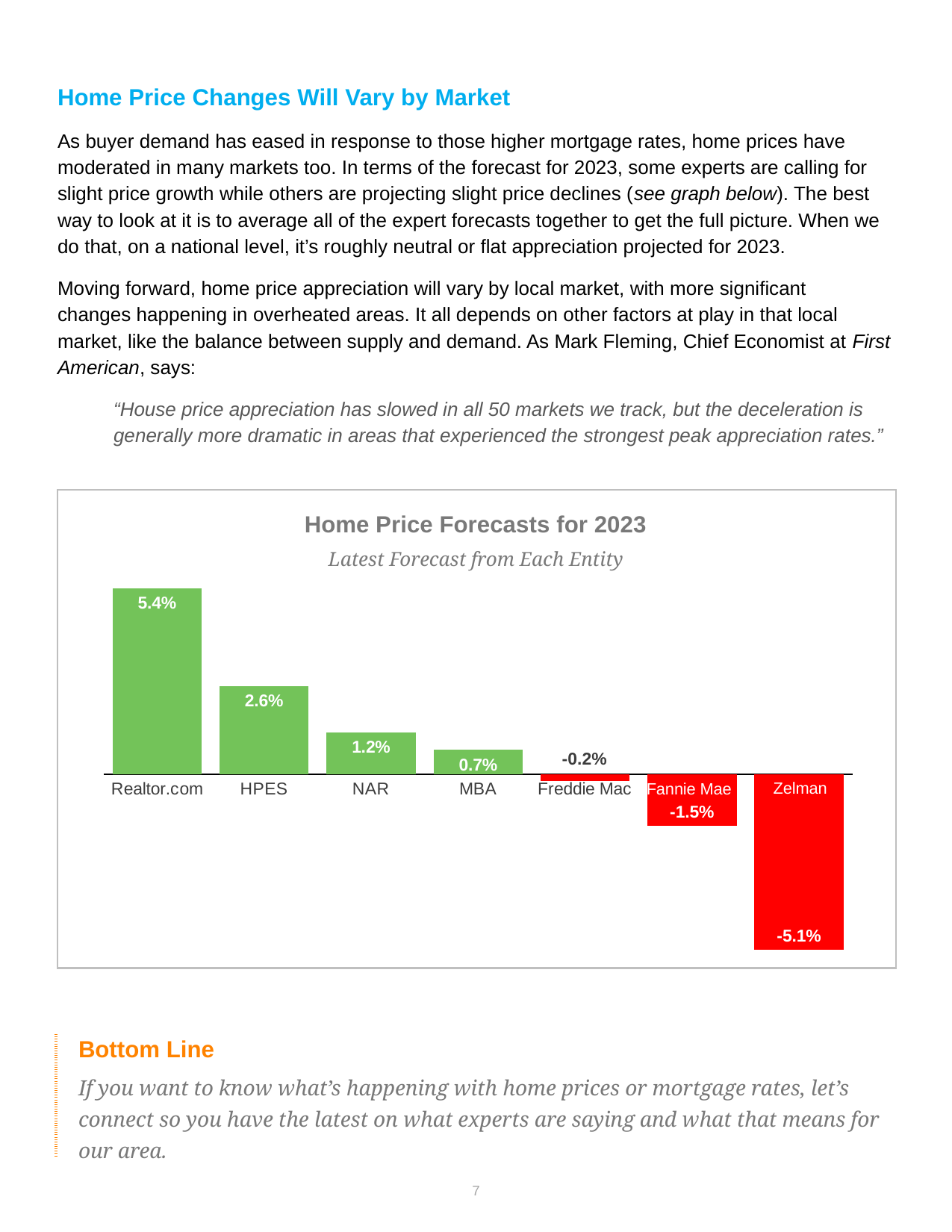
What is the difference between the HPES forecast and the NAR forecast? 1.4% What is the home price forecast for 2023 from MBA? 0.7% What is the home price forecast for 2023 from Realtor.com? 5.4% What colour are the bars for entities forecasting price declines? Red Do the forecast values rise or fall moving from left to right across the chart? Fall What is the home price forecast for 2023 from Fannie Mae? -1.5% What is the subtitle of the Home Price Forecasts for 2023 chart? Latest Forecast from Each Entity Which entity has the lowest home price forecast for 2023? Zelman What kind of chart is used to show the Home Price Forecasts for 2023? Bar chart How many entities are shown in the Home Price Forecasts for 2023 chart? 7 Which entity has the highest home price forecast for 2023? Realtor.com Which forecast is larger, Freddie Mac's or Fannie Mae's? Freddie Mac